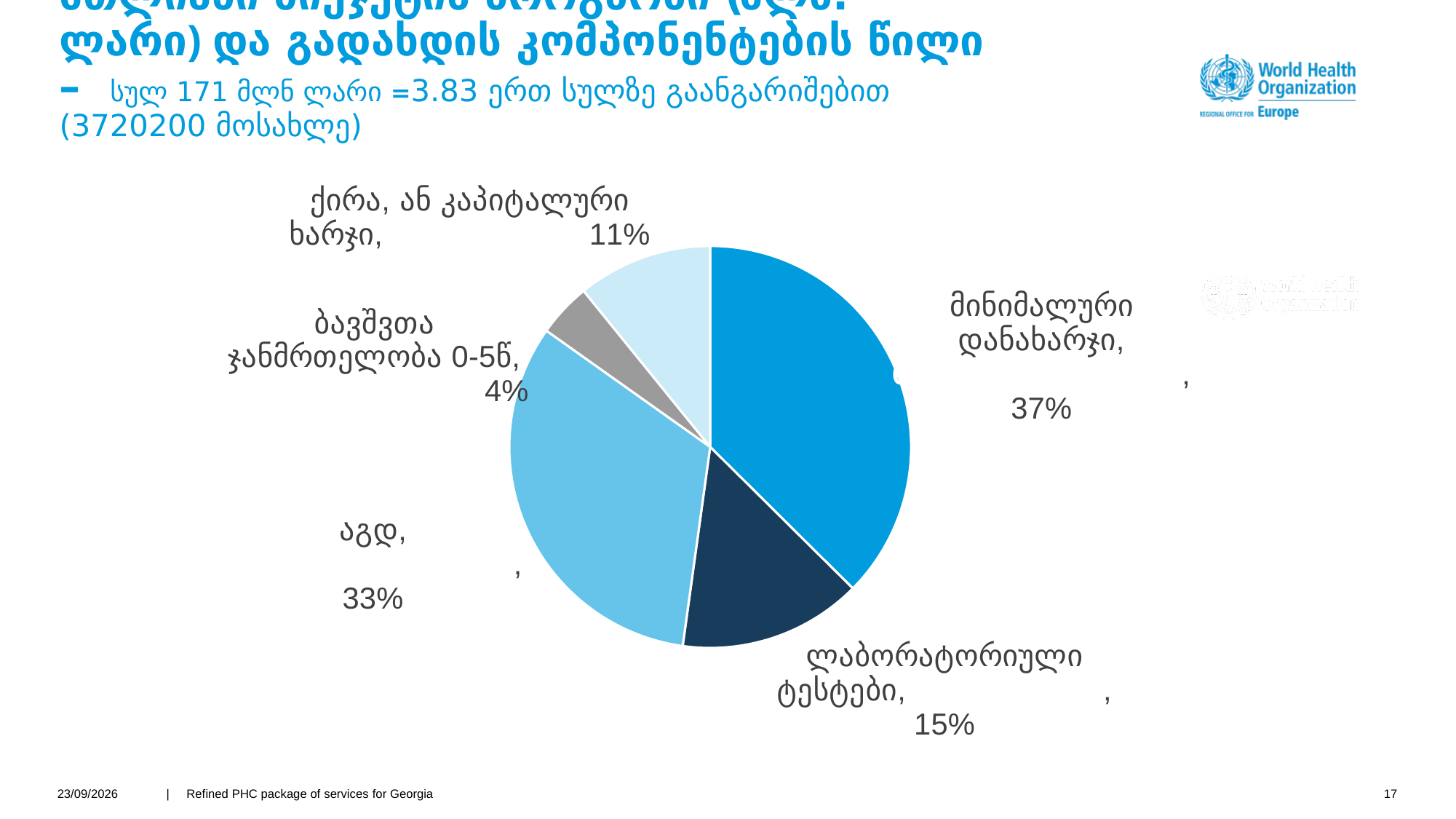
How many slices does the pie chart have? 5 Which is larger, the ლაბორატორიული ტესტები slice or the ქირა, ან კაპიტალური ხარჯი slice? ლაბორატორიული ტესტები What is the difference in percentage points between the მინიმალური დანახარჯი slice and the აგდ slice? 4 Which slice of the pie chart is the largest? მინიმალური დანახარჯი What share of the pie is labelled ლაბორატორიული ტესტები? 15% What share of the pie is labelled ქირა, ან კაპიტალური ხარჯი? 11% What kind of chart is shown on the slide? pie chart Which slice of the pie chart is the smallest? ბავშვთა ჯანმრთელობა 0-5წ What share of the pie is labelled მინიმალური დანახარჯი? 37% What colour is the ბავშვთა ჯანმრთელობა 0-5წ slice? grey